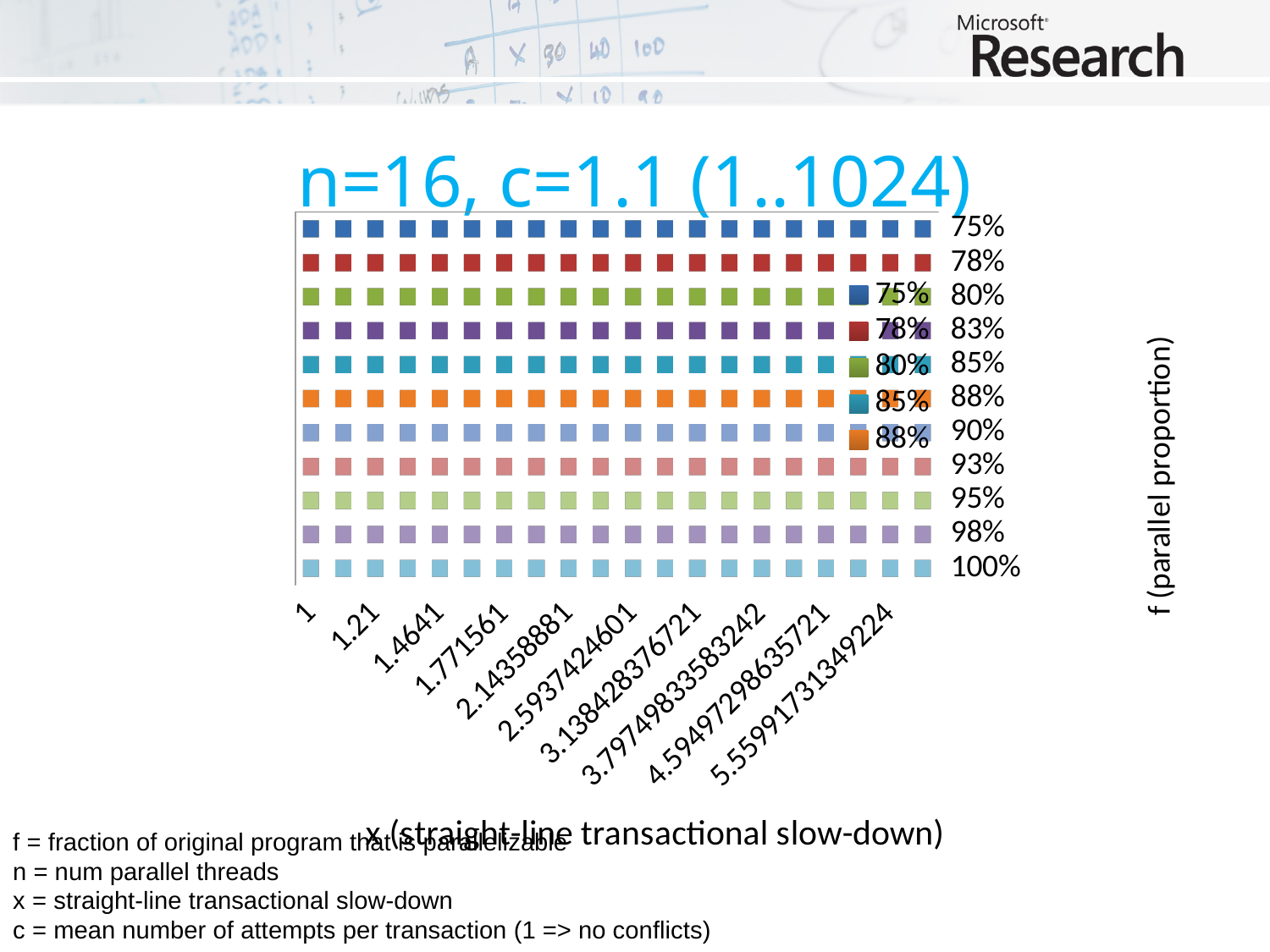
What is the title of the horizontal axis of the chart? x (straight-line transactional slow-down) How many x-axis tick labels are printed along the bottom of the chart? 10 What is the title of the chart? n=16, c=1.1 (1..1024) What is the lowest f (parallel proportion) value labelled on the chart's right-hand axis? 75% What is the highest f (parallel proportion) value labelled on the chart's right-hand axis? 100% What is the second x-axis tick label on the chart? 1.21 What is the first x-axis tick label on the chart? 1 How many f (parallel proportion) levels are labelled on the right-hand axis of the chart? 11